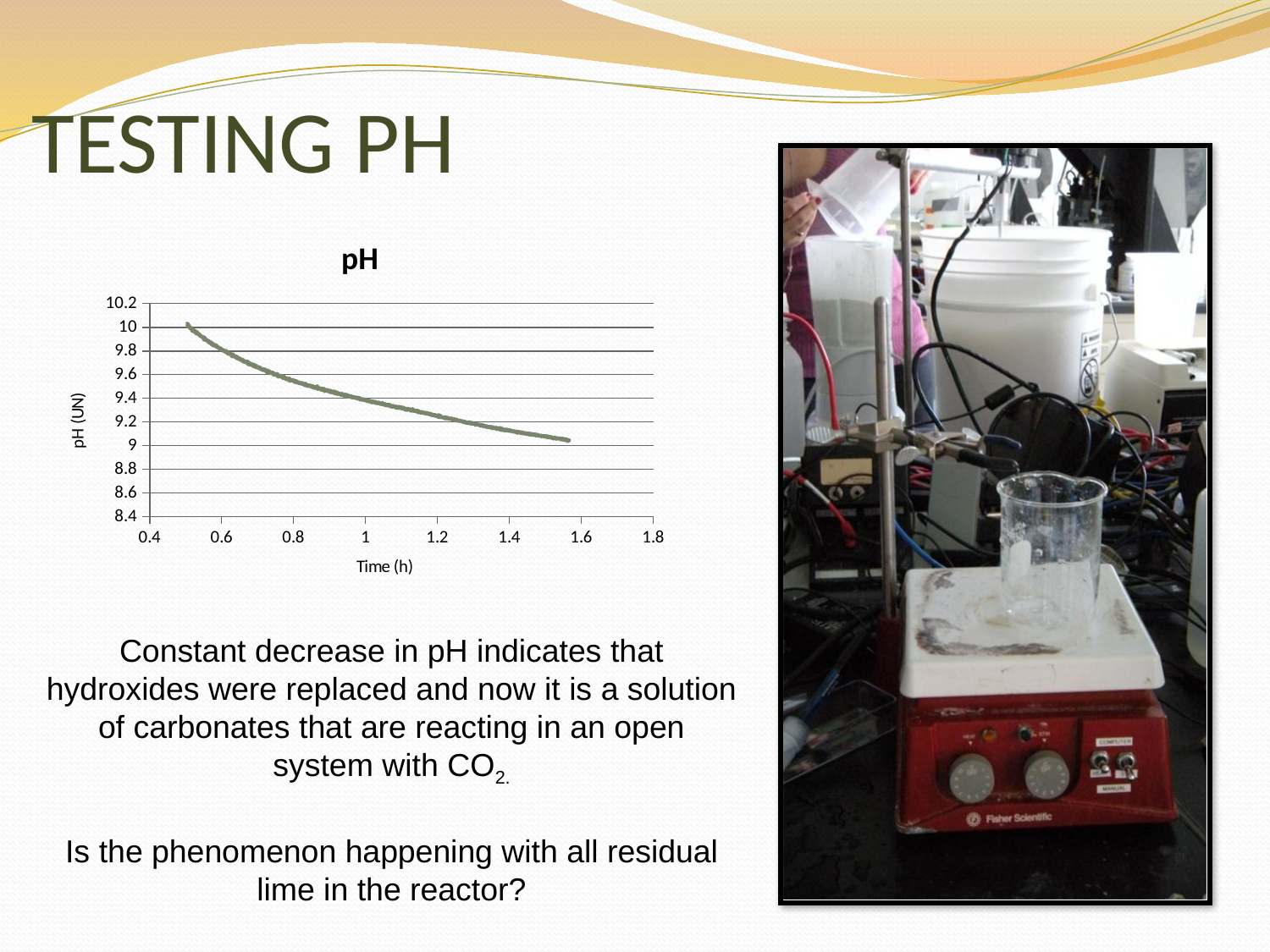
What is the title of the chart? pH Which is larger, the pH value at 0.6 h or the pH value at 1.4 h? 0.6 h Is the pH value at 1 h greater or less than 9.2? greater Is the pH value at 1.4 h greater or less than 9.4? less Is the pH value at 1 h greater or less than 9.6? less Do the pH values rise or fall as time increases along the x axis? fall What is the label of the y axis of the chart? pH (UN) What kind of chart is shown on the slide? line chart